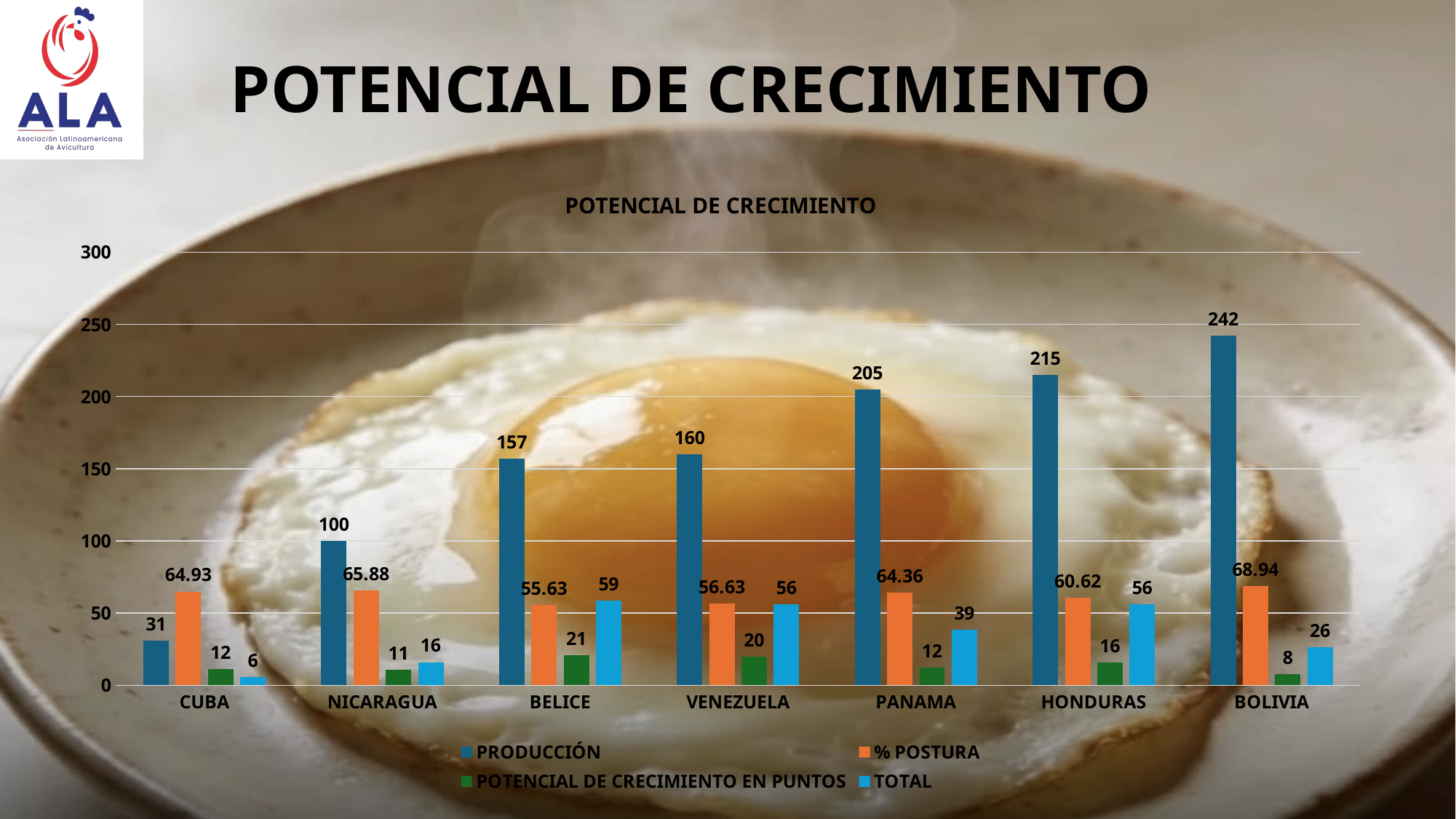
What is the difference between the PRODUCCIÓN values for BOLIVIA and HONDURAS? 27 What kind of chart is shown on the slide? Bar chart How many countries are shown on the x axis? 7 Which country has the lowest TOTAL value? CUBA What is the title of the chart? POTENCIAL DE CRECIMIENTO What is the PRODUCCIÓN value for PANAMA? 205 Which country has the highest PRODUCCIÓN value? BOLIVIA What is the POTENCIAL DE CRECIMIENTO EN PUNTOS value for VENEZUELA? 20 What is the % POSTURA value for NICARAGUA? 65.88 How many series does the legend list? 4 Which is larger, the % POSTURA value for CUBA or for PANAMA? CUBA What is the TOTAL value for BELICE? 59